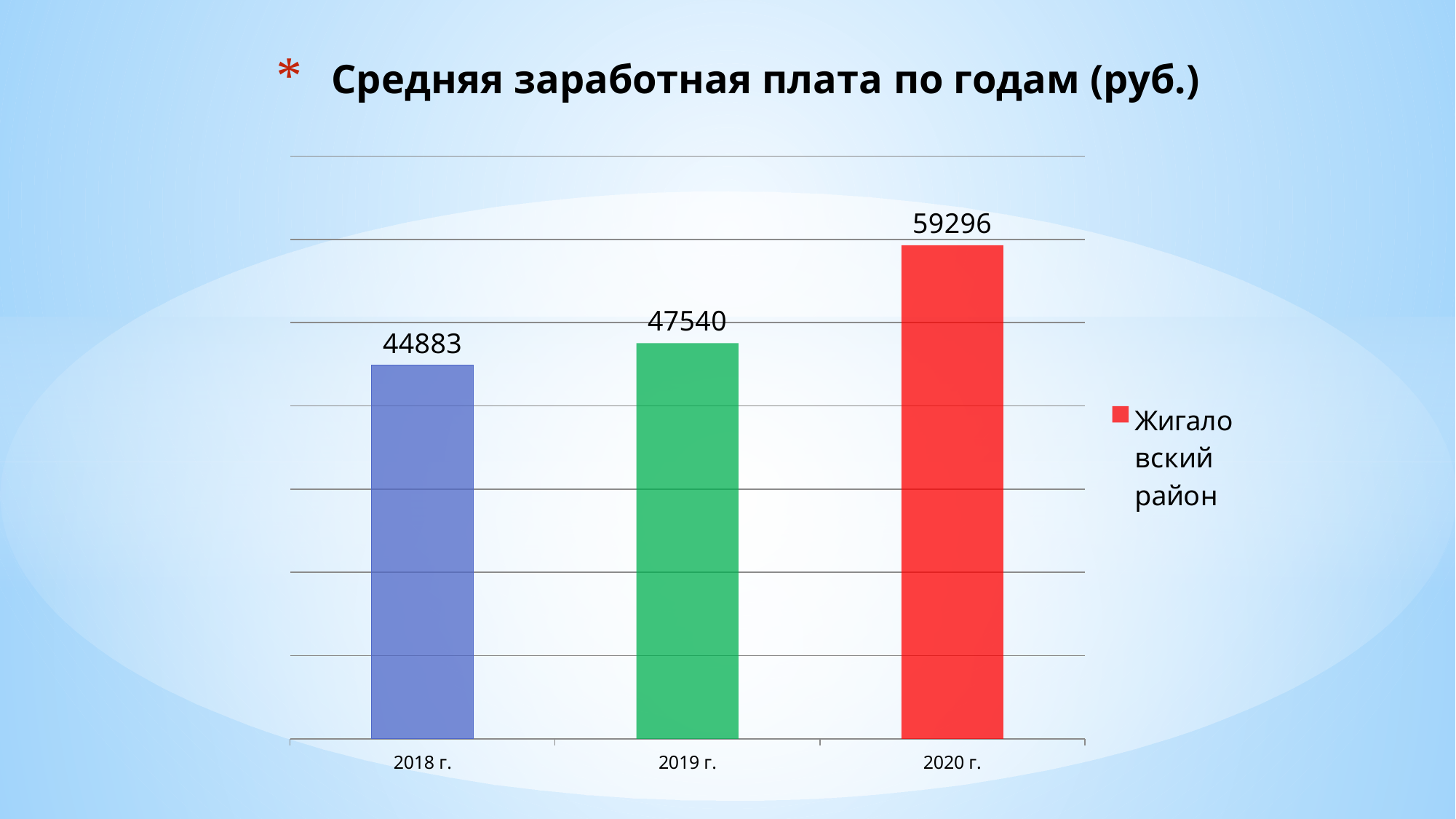
What is the average salary shown for 2020 г.? 59296 Which year has the highest average salary? 2020 г. What is the difference between the average salary in 2019 г. and 2018 г.? 2657 What is the average salary shown for 2018 г.? 44883 What is the average salary shown for 2019 г.? 47540 How many series does the legend list? 1 Which is larger, the average salary in 2018 г. or in 2019 г.? 2019 г. Do the average salary values rise or fall from 2018 г. to 2020 г.? Rise How many years are shown on the chart? 3 What kind of chart is shown on the slide? Bar chart Which year has the lowest average salary? 2018 г. What is the difference between the average salary in 2020 г. and 2019 г.? 11756